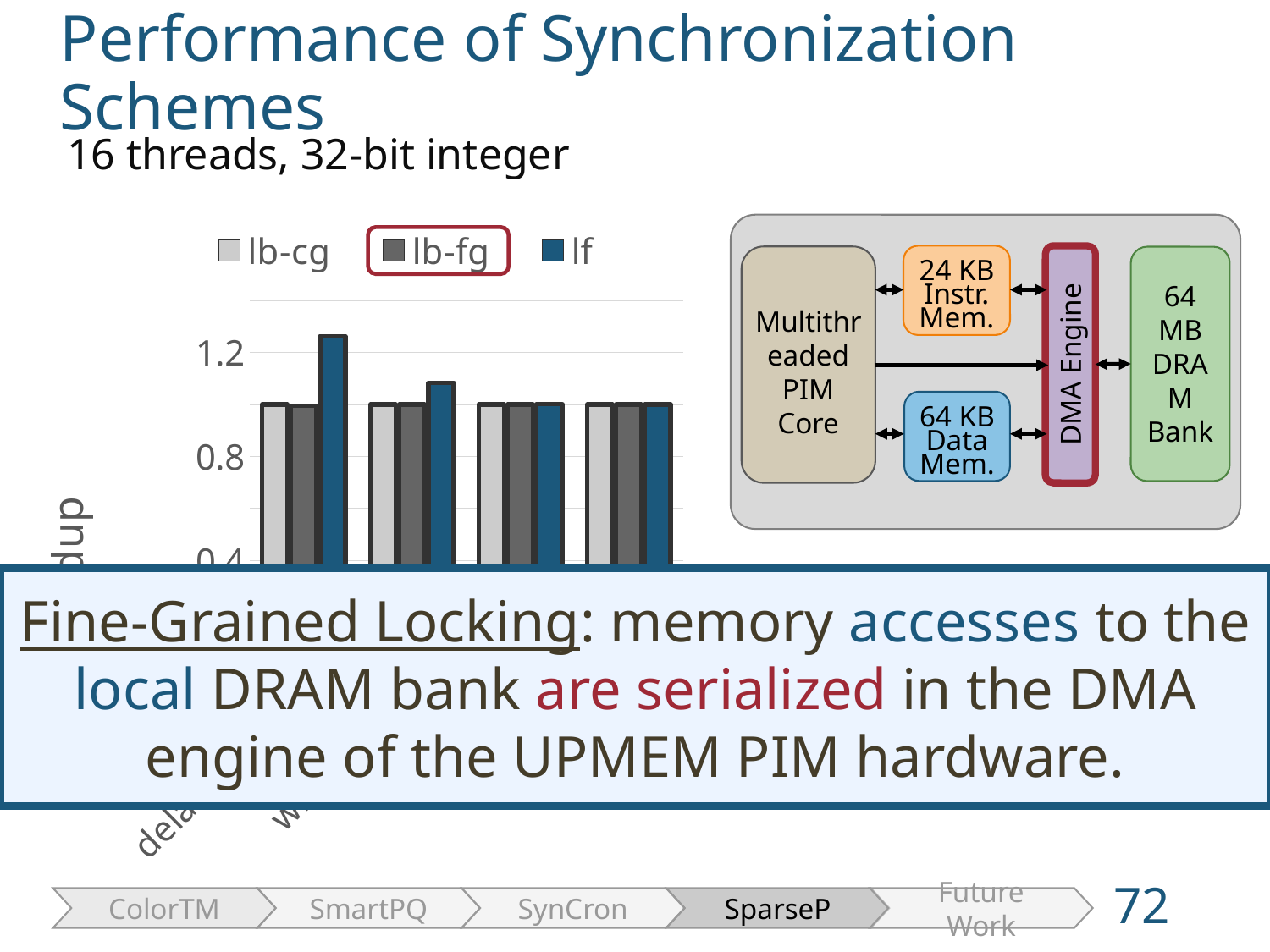
What are the three series named in the legend of the bar chart? lb-cg, lb-fg, lf What kind of chart is shown on the left of the slide? bar chart How many series does the legend of the bar chart list? 3 How many groups of bars are plotted in the bar chart? 4 Is the lf bar in the leftmost group greater or less than 1.2? greater Which series in the bar chart is drawn in dark blue? lf In the leftmost group of bars, which series has the tallest bar? lf Is the lf bar in the second group from the left greater or less than 1.2? less Is the lf bar in the second group from the left greater or less than 0.8? greater In the leftmost group, is the lf bar taller or shorter than the lb-fg bar? taller Which legend entry of the bar chart is outlined with a red box? lb-fg